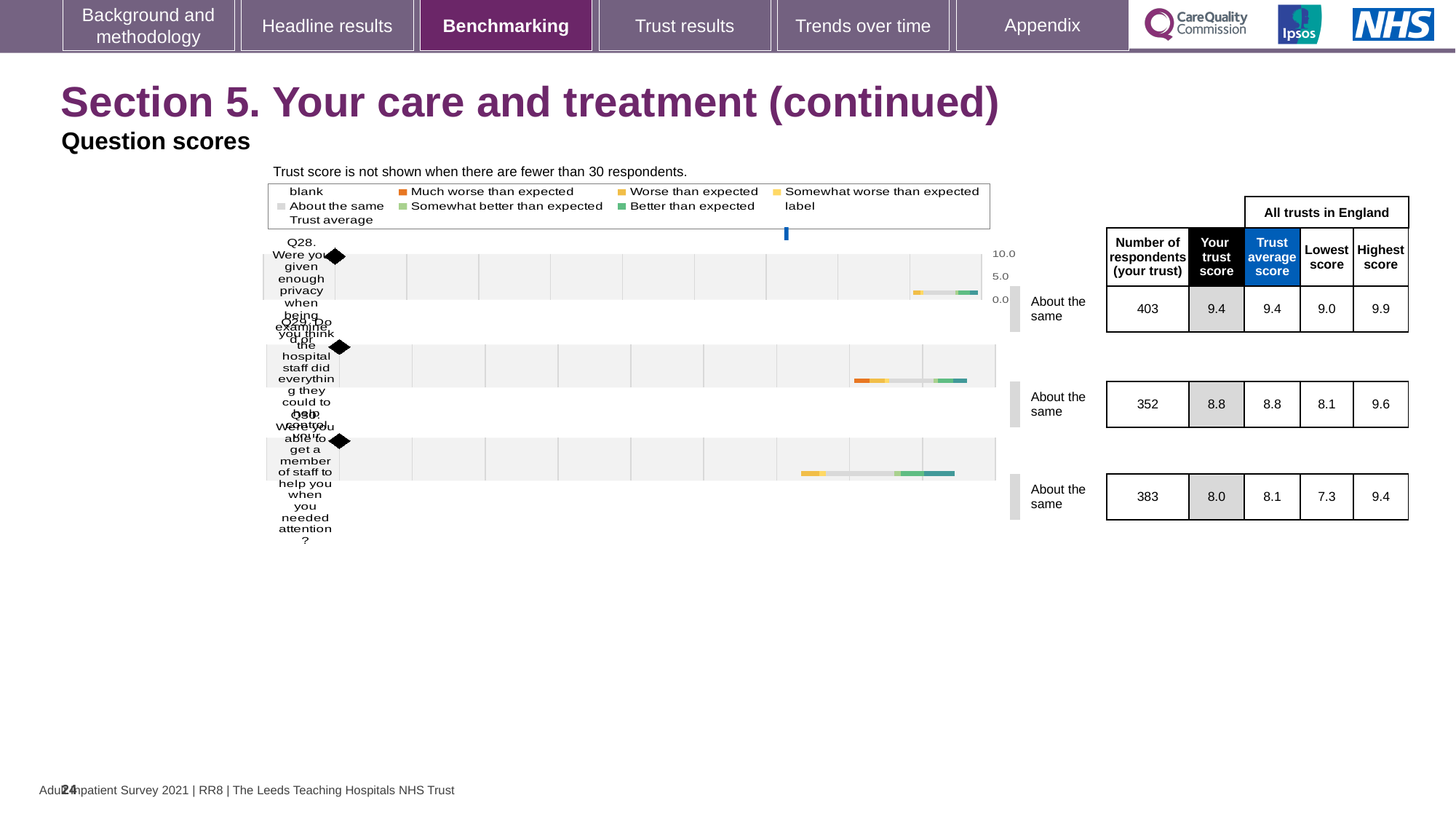
What is the maximum value shown on the score axis of the charts? 10.0 What is the trust score for Q29 (Do you think the hospital staff did everything they could to help control your pain?) shown on the slide? 8.8 What is the lowest score across all trusts in England for Q28? 9.0 What is the trust score for Q28 (Were you given enough privacy when being examined or treated?) shown on the slide? 9.4 Which of the three questions has the lowest trust score? Q30 How many questions (Q28, Q29, Q30) are plotted on the slide? 3 What benchmark category is shown for all three questions on the slide? About the same What is the number of respondents for Q29 shown on the slide? 352 What is the difference between the trust score for Q28 and the trust score for Q30? 1.4 What is the highest score across all trusts in England for Q30? 9.4 Which of the three questions has the highest trust score? Q28 What is the trust score for Q30 (Were you able to get a member of staff to help you when you needed attention?) shown on the slide? 8.0